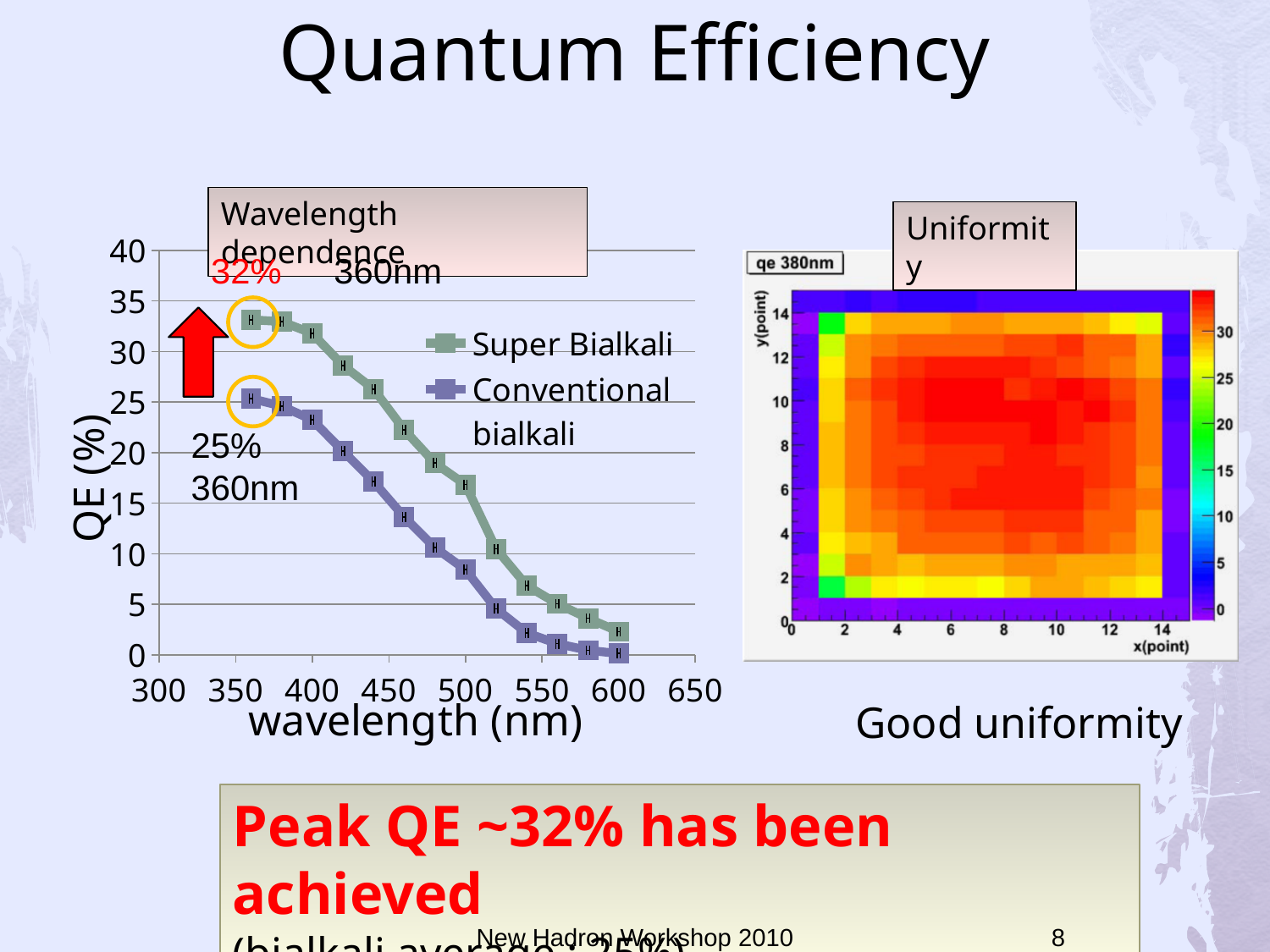
On the Wavelength dependence chart, is the QE of Super Bialkali at 600 nm greater or less than 5? less On the Wavelength dependence chart, is the QE of Conventional bialkali at 400 nm greater or less than 20? greater On the Wavelength dependence chart, what is the difference between the annotated QE values of Super Bialkali and Conventional bialkali at 360nm? 7% On the Wavelength dependence chart, is the QE of Super Bialkali at 500 nm greater or less than 10? greater What is the label of the y axis on the Wavelength dependence chart? QE (%) On the Wavelength dependence chart, which series has the higher QE at 360nm, Super Bialkali or Conventional bialkali? Super Bialkali What is the label of the x axis on the Wavelength dependence chart? wavelength (nm) How many series does the legend of the Wavelength dependence chart list? 2 On the Wavelength dependence chart, what QE value is annotated for Conventional bialkali at 360nm? 25% On the Wavelength dependence chart, what QE value is annotated for Super Bialkali at 360nm? 32% What kind of chart is the Wavelength dependence chart on the left? Line chart On the Wavelength dependence chart, how do the QE values change as wavelength increases from 360 nm to 600 nm? They fall